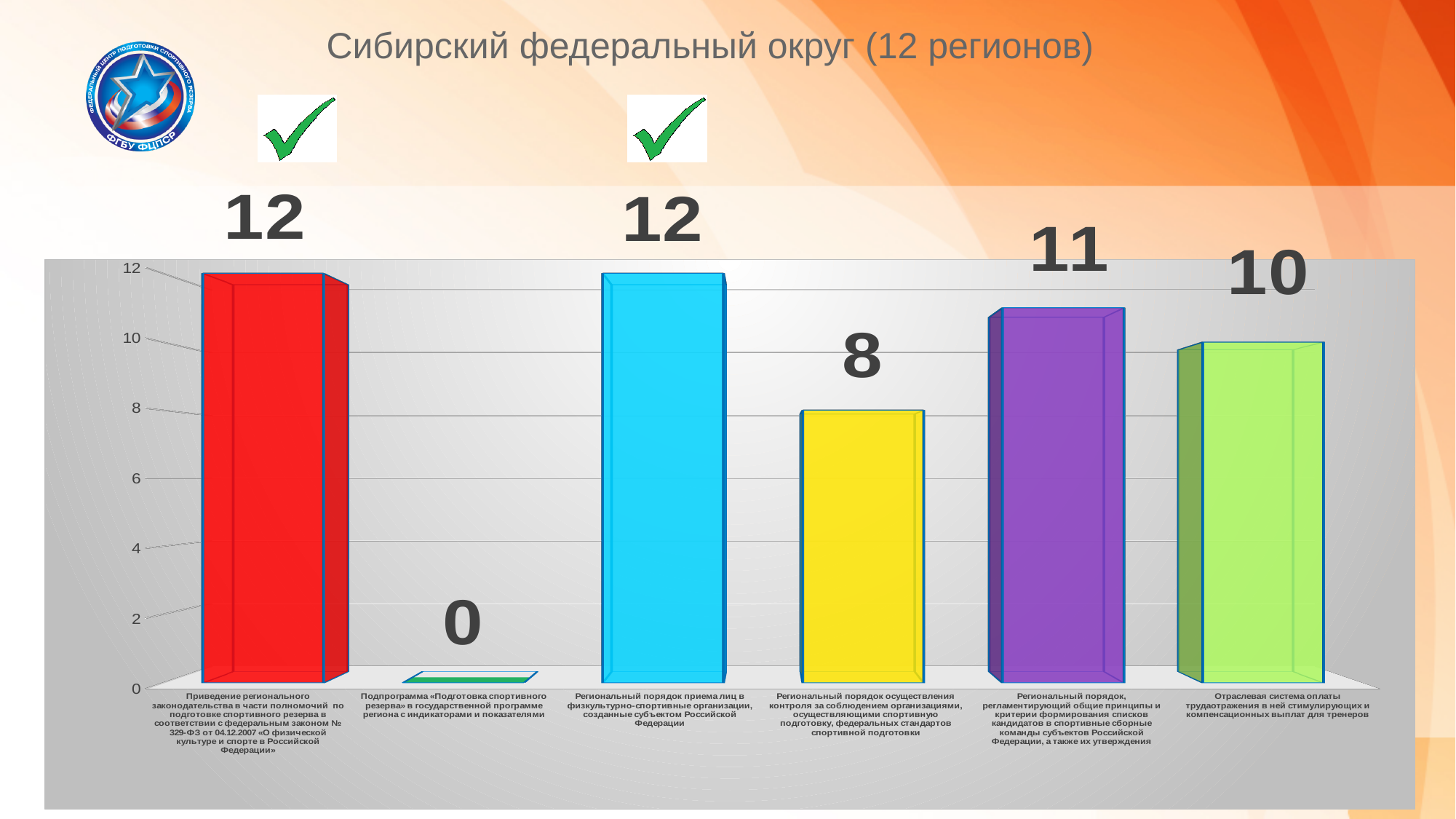
What kind of chart is shown on the slide? bar chart What is the difference between the value for «Приведение регионального законодательства» (12) and the value for «Региональный порядок осуществления контроля» (8)? 4 What is the value for «Региональный порядок, регламентирующий общие принципы и критерии формирования списков кандидатов в спортивные сборные команды»? 11 What is the value for «Отраслевая система оплаты труда» (the rightmost bar)? 10 How many categories are shown in the chart? 6 Which is larger: the value for «Региональный порядок, регламентирующий общие принципы...» or the value for «Отраслевая система оплаты труда»? Региональный порядок, регламентирующий общие принципы... What is the value for «Подпрограмма «Подготовка спортивного резерва» в государственной программе региона»? 0 What is the title of the slide? Сибирский федеральный округ (12 регионов) Which category has the lowest value? Подпрограмма «Подготовка спортивного резерва» в государственной программе региона с индикаторами и показателями What colour is the bar for «Региональный порядок приема лиц в физкультурно-спортивные организации»? cyan (light blue) What is the value for «Региональный порядок осуществления контроля за соблюдением организациями... федеральных стандартов спортивной подготовки»? 8 Is the value for «Региональный порядок осуществления контроля» greater or less than 10? less